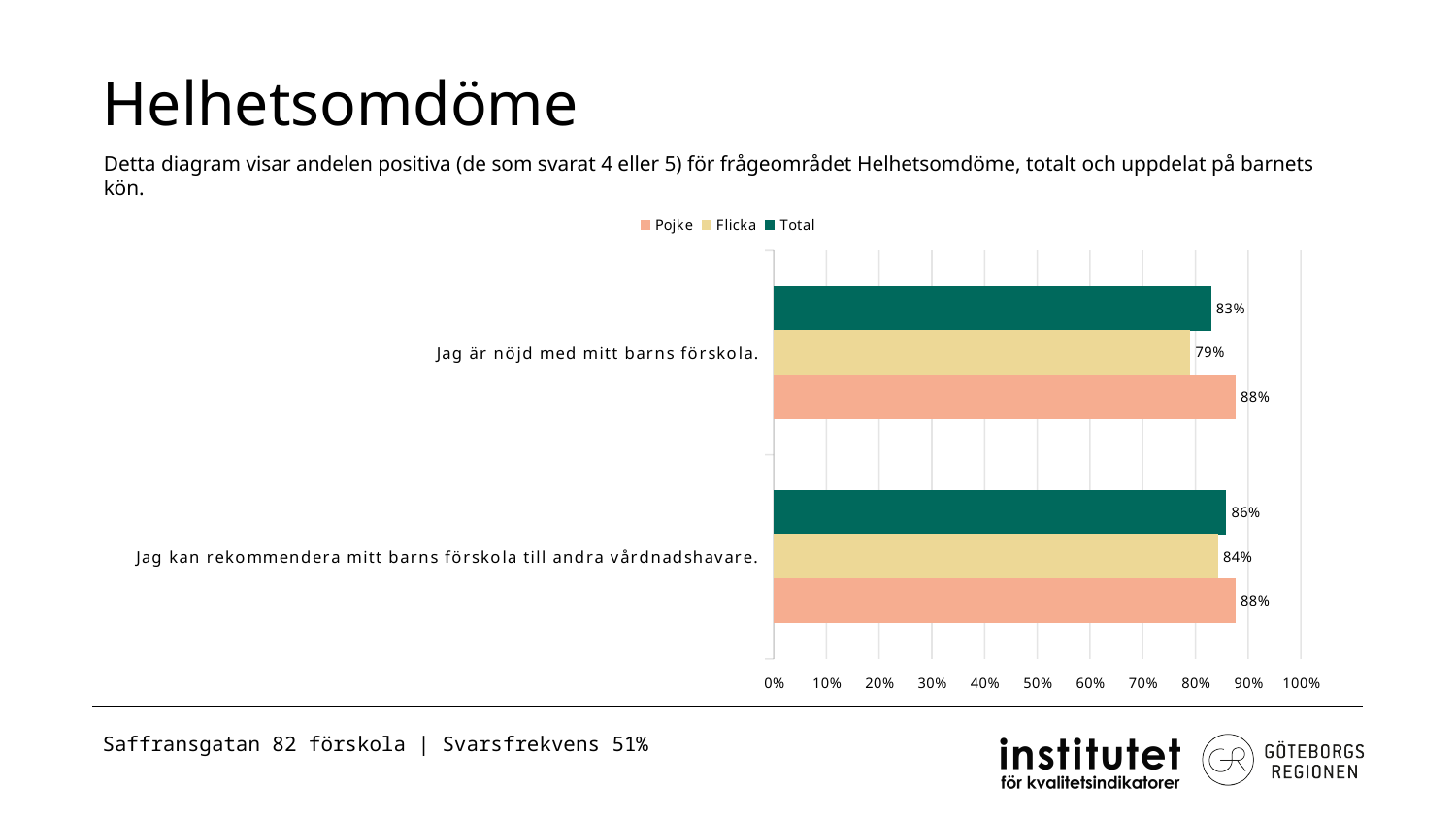
What is the Flicka value for "Jag kan rekommendera mitt barns förskola till andra vårdnadshavare."? 84% What is the Total value for "Jag kan rekommendera mitt barns förskola till andra vårdnadshavare."? 86% Is the Flicka value for "Jag är nöjd med mitt barns förskola." larger or smaller than the Flicka value for "Jag kan rekommendera mitt barns förskola till andra vårdnadshavare."? smaller What kind of chart is shown on the slide? Bar chart Which series has the lowest value for "Jag är nöjd med mitt barns förskola."? Flicka Which series has the highest value for "Jag kan rekommendera mitt barns förskola till andra vårdnadshavare."? Pojke What is the Pojke value for "Jag är nöjd med mitt barns förskola."? 88% What is the difference between the Pojke and Flicka values for "Jag är nöjd med mitt barns förskola."? 9 percentage points How many statements (categories) are shown in the chart? 2 What is the Flicka value for "Jag är nöjd med mitt barns förskola."? 79% What is the difference between the Total values for the two statements? 3 percentage points How many series does the legend list? 3